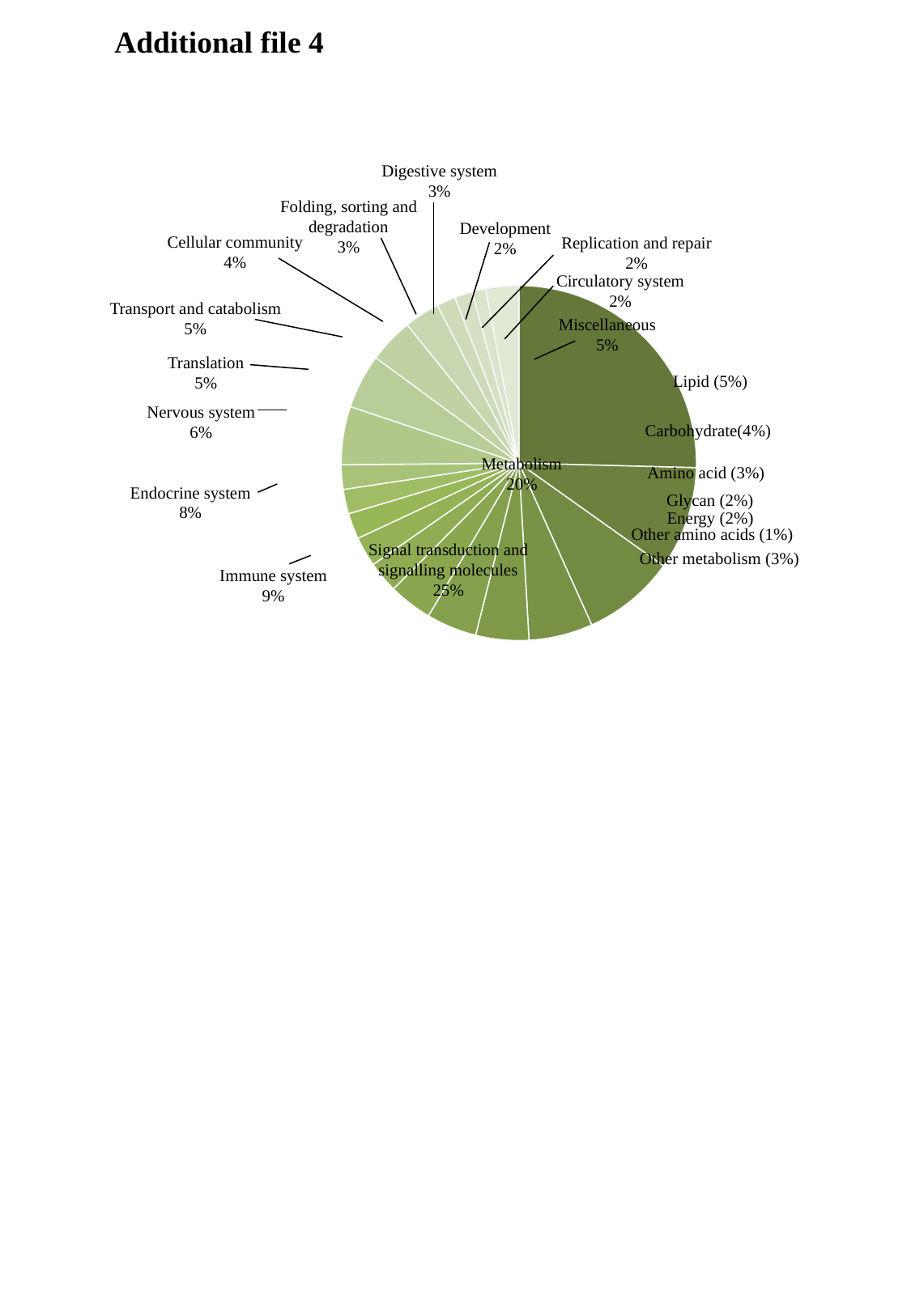
What percentage is shown for Lipid? 5% Which category has the largest share of the pie? Signal transduction and signalling molecules What share of the pie does Signal transduction and signalling molecules represent? 25% Which category has the smallest share of the pie? Other amino acids What is the title shown at the top of the slide? Additional file 4 What is the difference in percentage points between Signal transduction and signalling molecules and Metabolism? 5 What percentage is shown for Endocrine system? 8% Which has a larger share, Nervous system or Cellular community? Nervous system What kind of chart is shown on the slide? pie chart What percentage is shown for Other amino acids? 1% What is the difference in percentage points between Immune system and Endocrine system? 1 What percentage is shown for Immune system? 9%